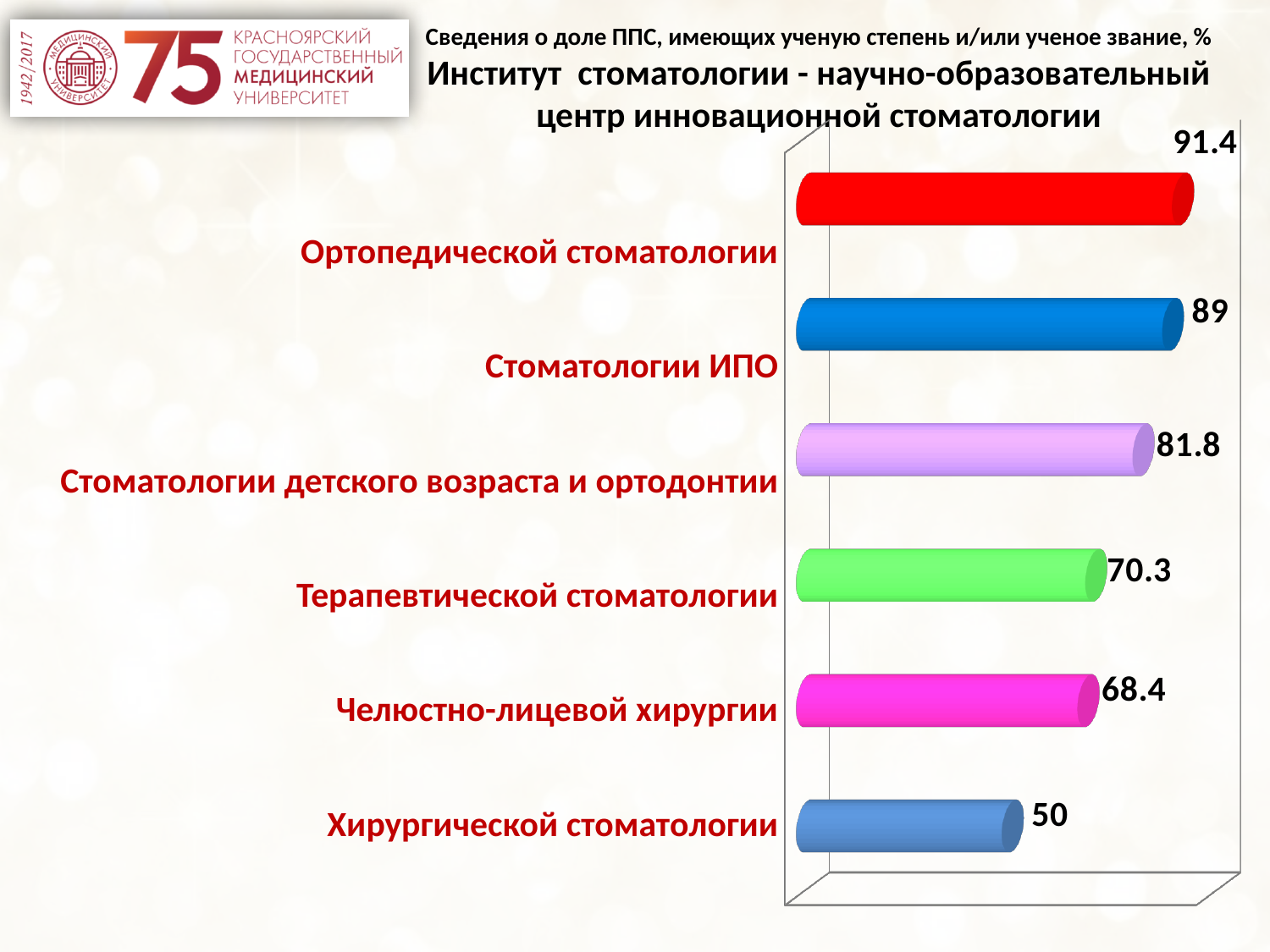
Which is larger, the value for Терапевтической стоматологии or Челюстно-лицевой хирургии? Терапевтической стоматологии Which category has the highest value? Ортопедической стоматологии What kind of chart is shown on the slide? Bar chart What is the value for Терапевтической стоматологии? 70.3 What is the value for Челюстно-лицевой хирургии? 68.4 What is the value for Ортопедической стоматологии? 91.4 How many categories are shown in the chart? 6 What is the value for Стоматологии детского возраста и ортодонтии? 81.8 What is the value for Хирургической стоматологии? 50 What is the value for Стоматологии ИПО? 89 What is the difference between the values for Ортопедической стоматологии and Хирургической стоматологии? 41.4 Which category has the lowest value? Хирургической стоматологии